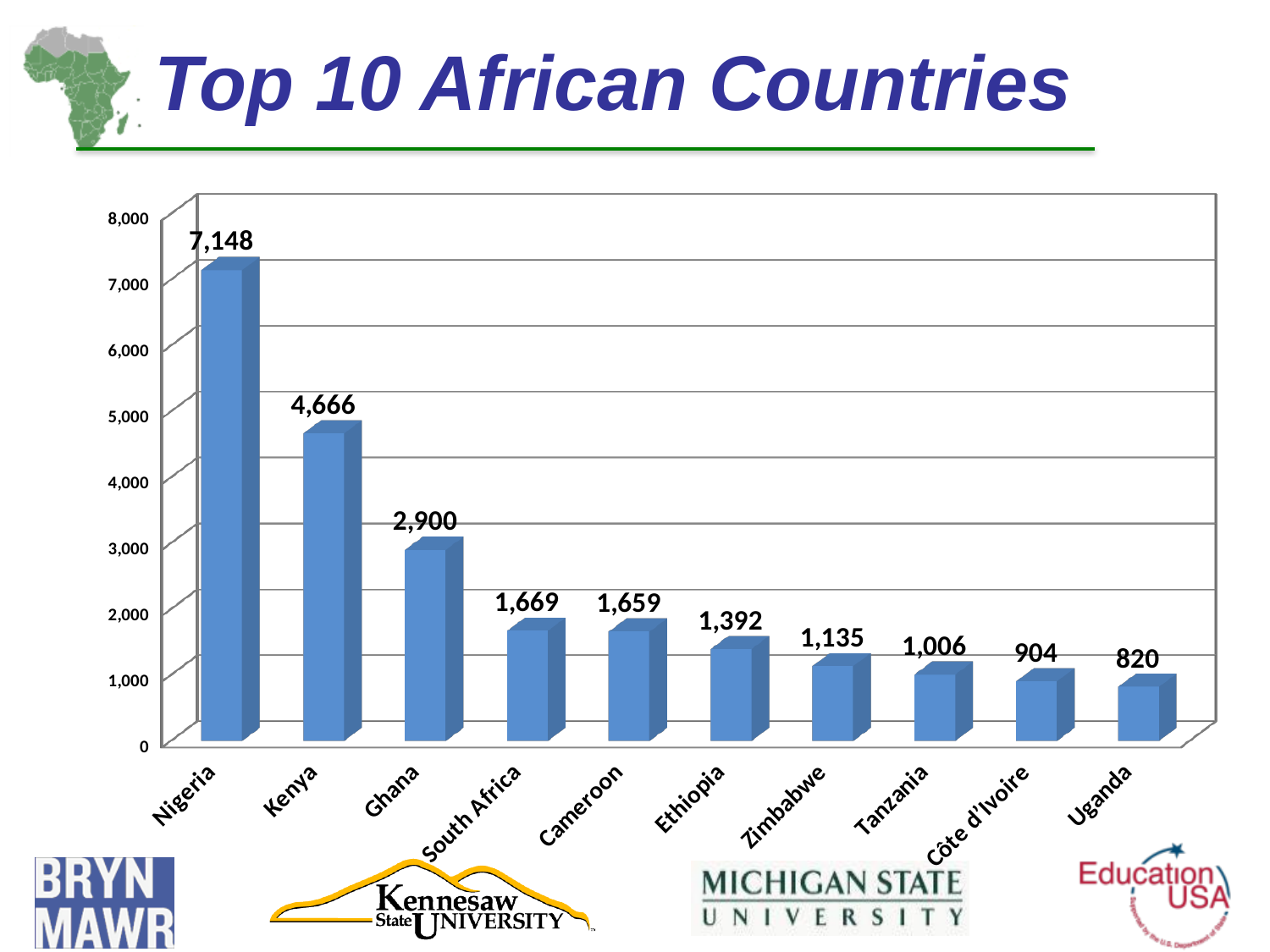
What is the value for Nigeria? 7,148 Which country has the highest value? Nigeria What is the difference between the values for Nigeria and Kenya? 2,482 Which country has the lowest value? Uganda How many countries are shown in the chart? 10 Do the values rise or fall from left to right along the x axis? fall What kind of chart is shown on the slide? bar chart Is the value for Kenya greater or less than 4,000? greater What is the difference between the values for Côte d'Ivoire and Uganda? 84 What is the value for Tanzania? 1,006 Which has a larger value, Ghana or Ethiopia? Ghana What is the value for Ghana? 2,900